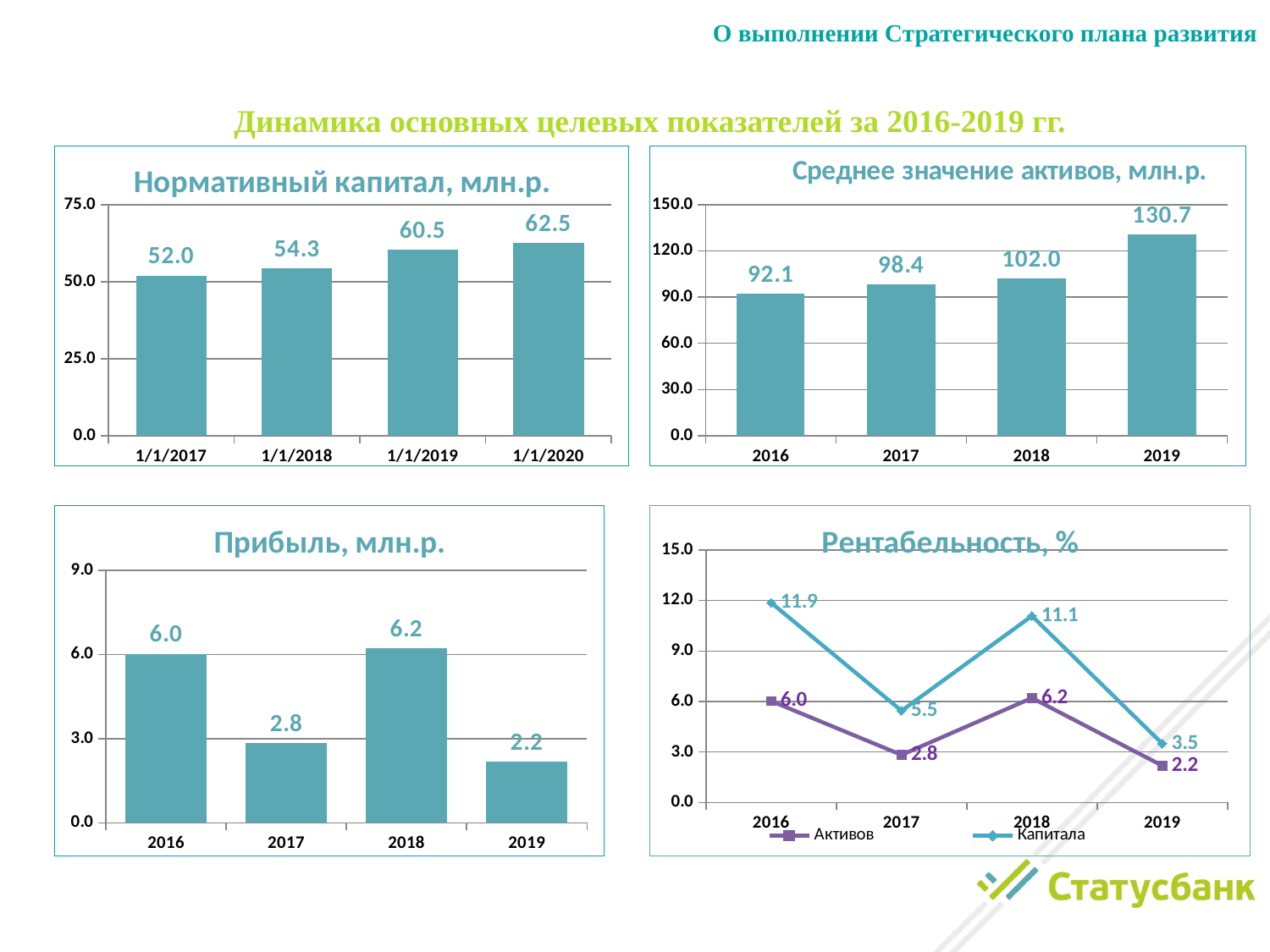
What kind of chart is the one titled "Прибыль, млн.р."? bar chart In the chart titled "Прибыль, млн.р.", which is larger, the value for 2016 or the value for 2018? 2018 In the chart titled "Рентабельность, %", what is the value of the "Капитала" series in 2018? 11.1 In the chart titled "Среднее значение активов, млн.р.", which year has the highest value? 2019 In the chart titled "Нормативный капитал, млн.р.", do the values rise or fall from 1/1/2017 to 1/1/2020? rise In the chart titled "Рентабельность, %", how many series does the legend list? 2 In the chart titled "Прибыль, млн.р.", which year has the lowest value? 2019 In the chart titled "Среднее значение активов, млн.р.", what is the value for 2017? 98.4 In the chart titled "Рентабельность, %", what is the difference between the "Капитала" and "Активов" values in 2016? 5.9 In the chart titled "Нормативный капитал, млн.р.", what is the difference between the values for 1/1/2020 and 1/1/2017? 10.5 In the chart titled "Среднее значение активов, млн.р.", how many bars are plotted? 4 In the chart titled "Нормативный капитал, млн.р.", what is the value for 1/1/2018? 54.3